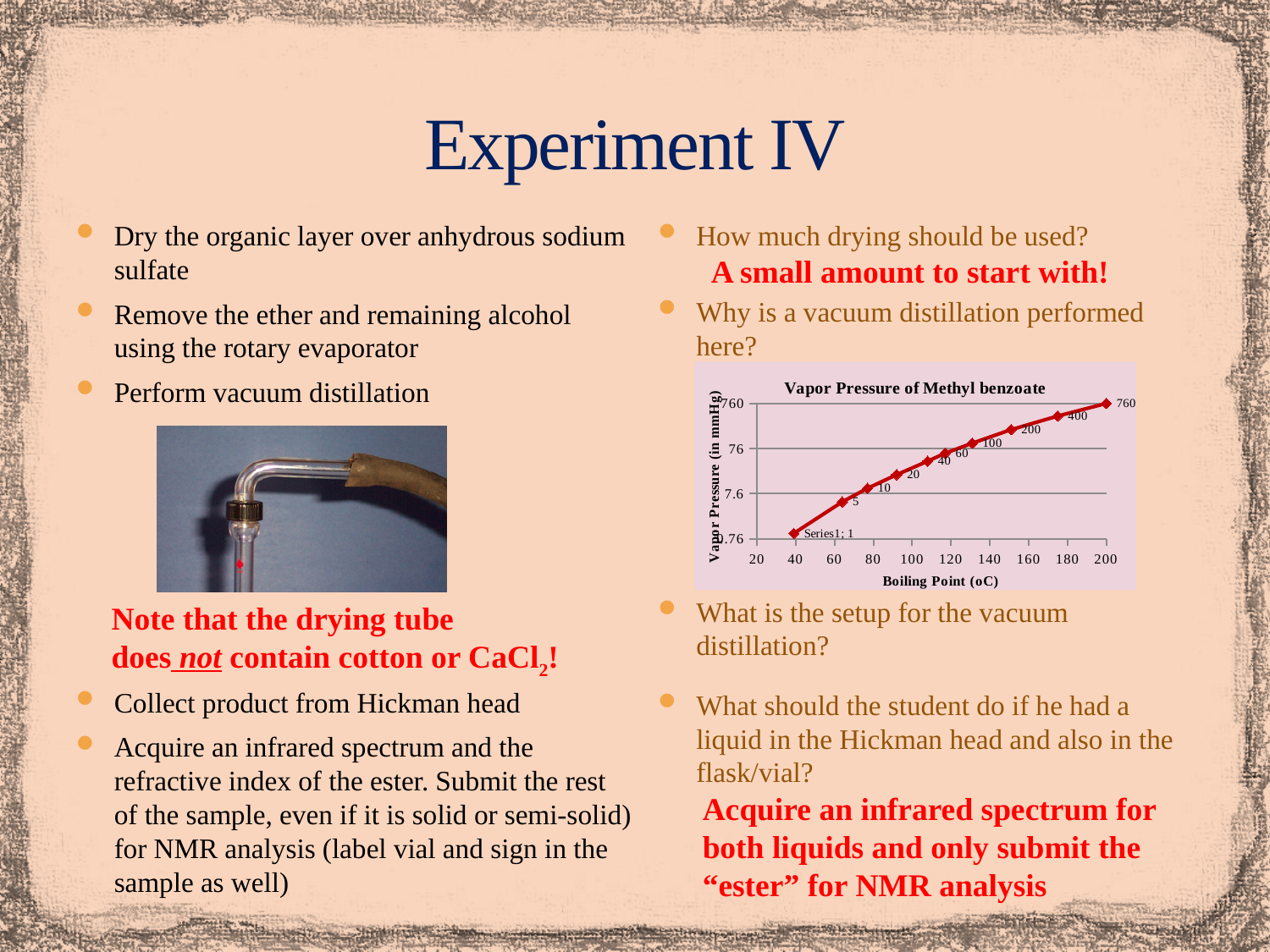
What type of chart is shown on the slide? line chart Is the value of the data point labeled 100 greater or less than 76 on the y axis? greater What is the title of the chart on the slide? Vapor Pressure of Methyl benzoate What is the lowest data label value shown on the chart? 1 How many lines (series) are plotted on the chart? 1 What is the label of the x axis of the chart? Boiling Point (oC) Which is larger, the data point labeled 400 or the data point labeled 200? 400 What is the difference between the two highest labeled values on the chart (760 and 400)? 360 What is the vapor pressure value labeled at the point with the highest boiling point (200 oC)? 760 How many data points are plotted on the chart? 10 Does the vapor pressure rise or fall as the boiling point increases along the x axis? rise What is the highest data label value shown on the chart? 760